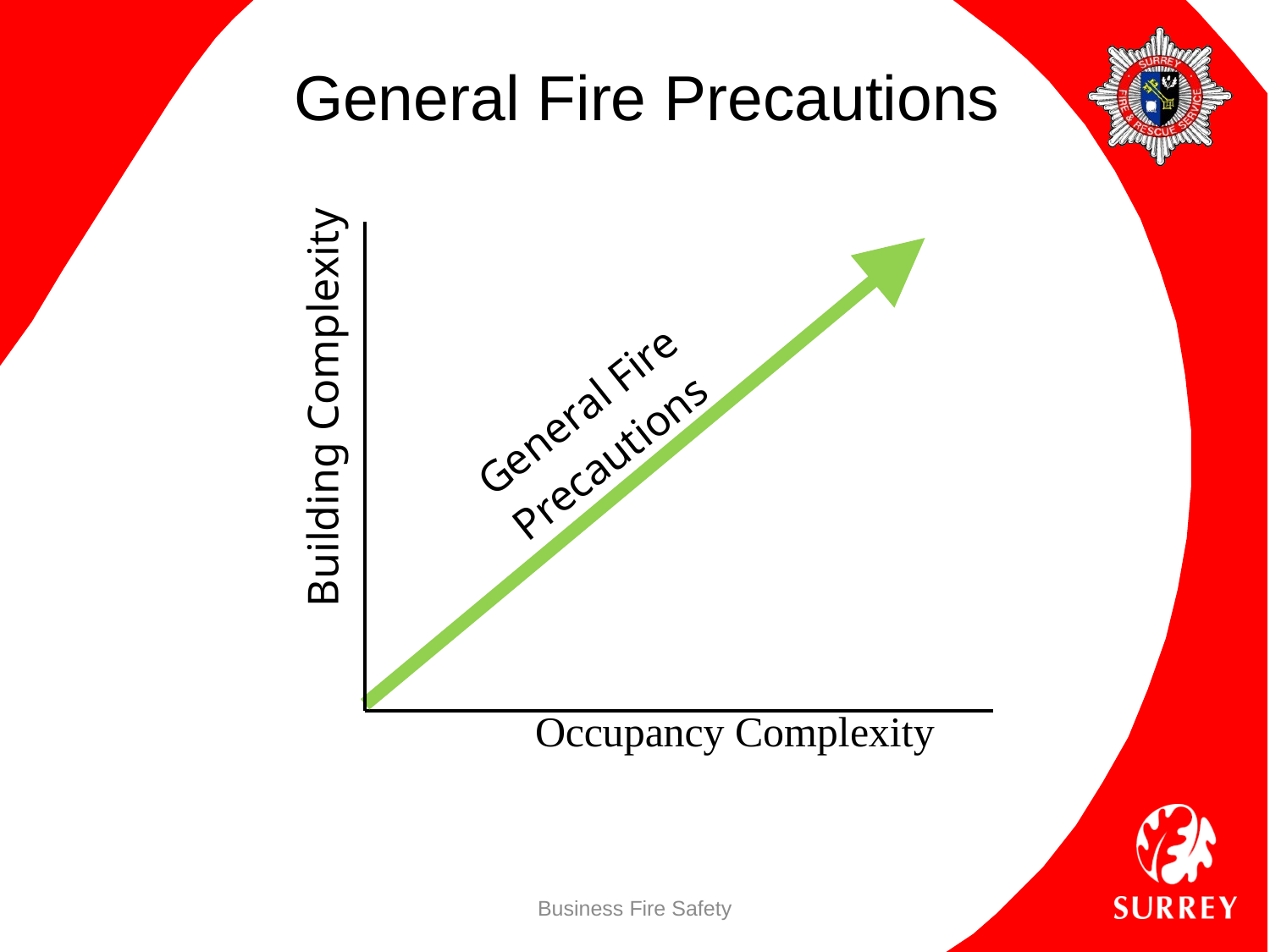
Does the General Fire Precautions arrow rise or fall as Occupancy Complexity increases along the x axis? rise According to the arrow, as Building Complexity increases, does the level of General Fire Precautions increase or decrease? increase What is the label on the vertical (y) axis of the chart? Building Complexity What is the label on the horizontal (x) axis of the chart? Occupancy Complexity